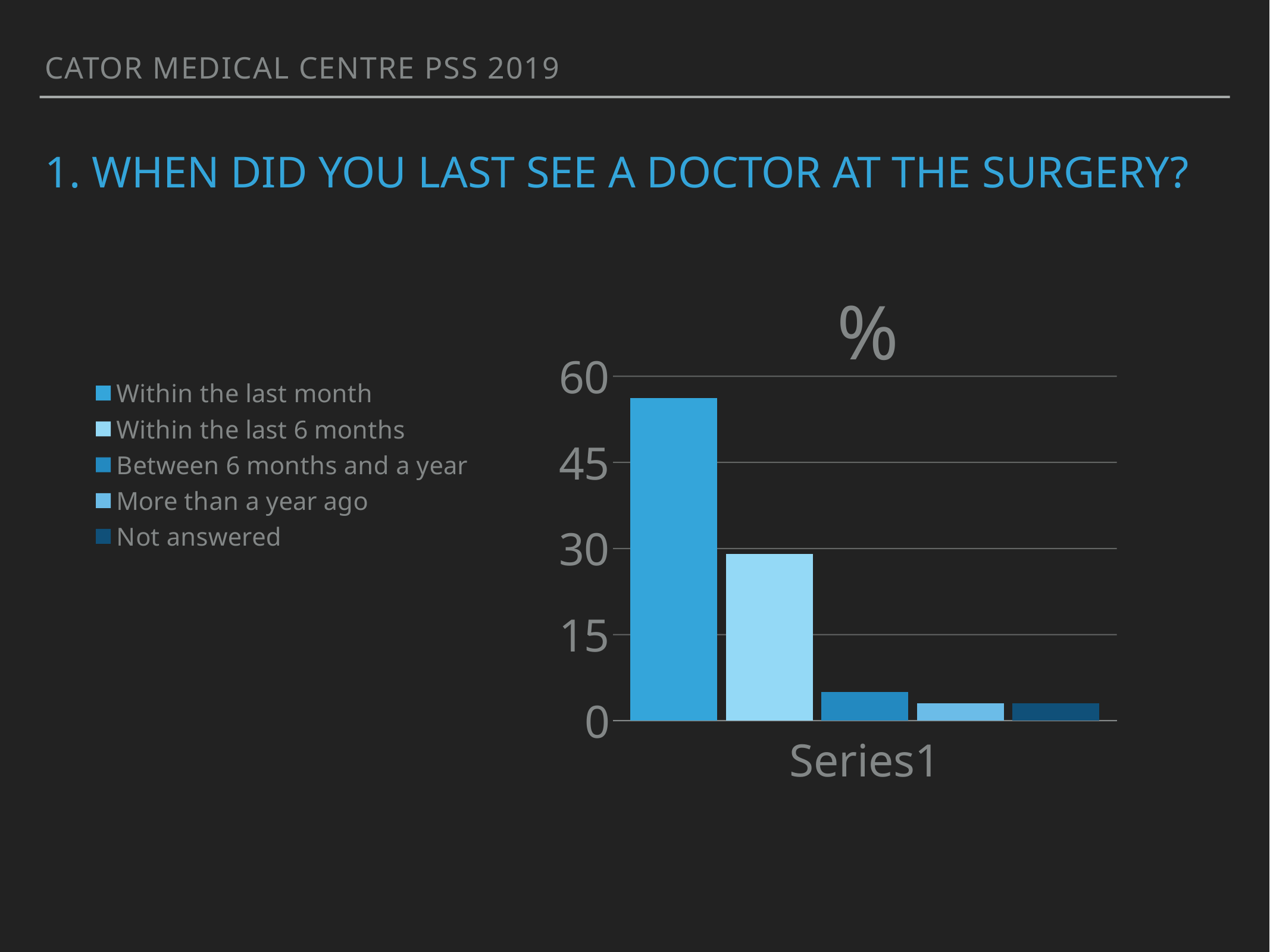
How many series does the legend list? 5 What is the title of the chart? % Which legend entry has the highest value? Within the last month Which is larger, the value for Within the last 6 months or the value for Between 6 months and a year? Within the last 6 months Is the value for Within the last month greater or less than 45? greater Is the value for Within the last 6 months greater or less than 15? greater Is the value for Within the last month greater or less than 60? less Which is larger, the value for Within the last month or the value for Within the last 6 months? Within the last month What label appears under the bars on the x axis? Series1 What kind of chart is shown on the slide? bar chart